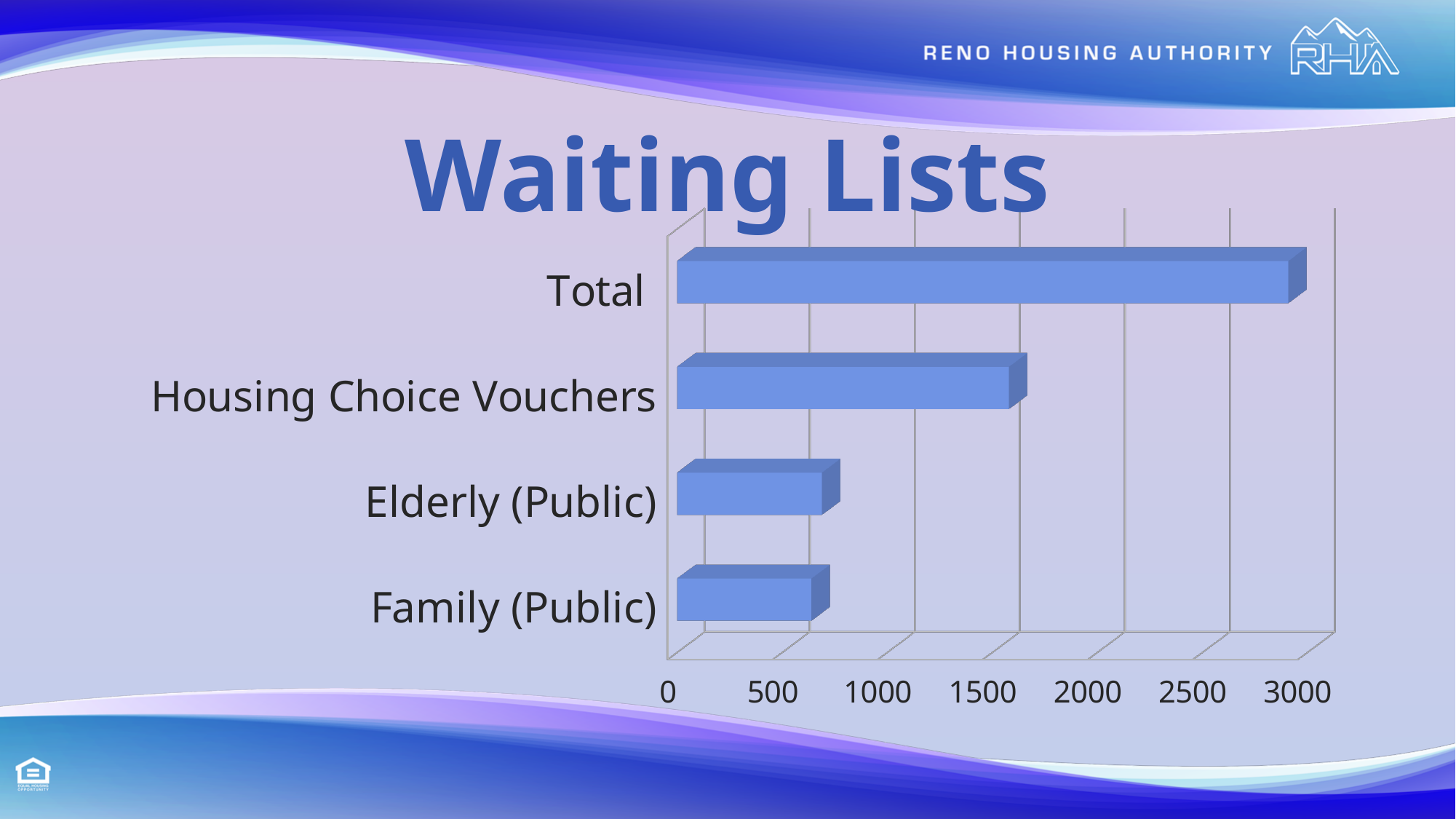
What is the title of the chart? Waiting Lists Which is larger, the value for Housing Choice Vouchers or the value for Elderly (Public)? Housing Choice Vouchers Is the value for Housing Choice Vouchers greater or less than 2000? less How many categories are plotted in the chart? 4 What kind of chart is shown on the slide? bar chart Which category has the highest value? Total Is the value for Total greater or less than 2500? greater Is the value for Family (Public) greater or less than 1000? less Which is larger, the value for Total or the value for Housing Choice Vouchers? Total What is the highest value shown on the horizontal axis? 3000